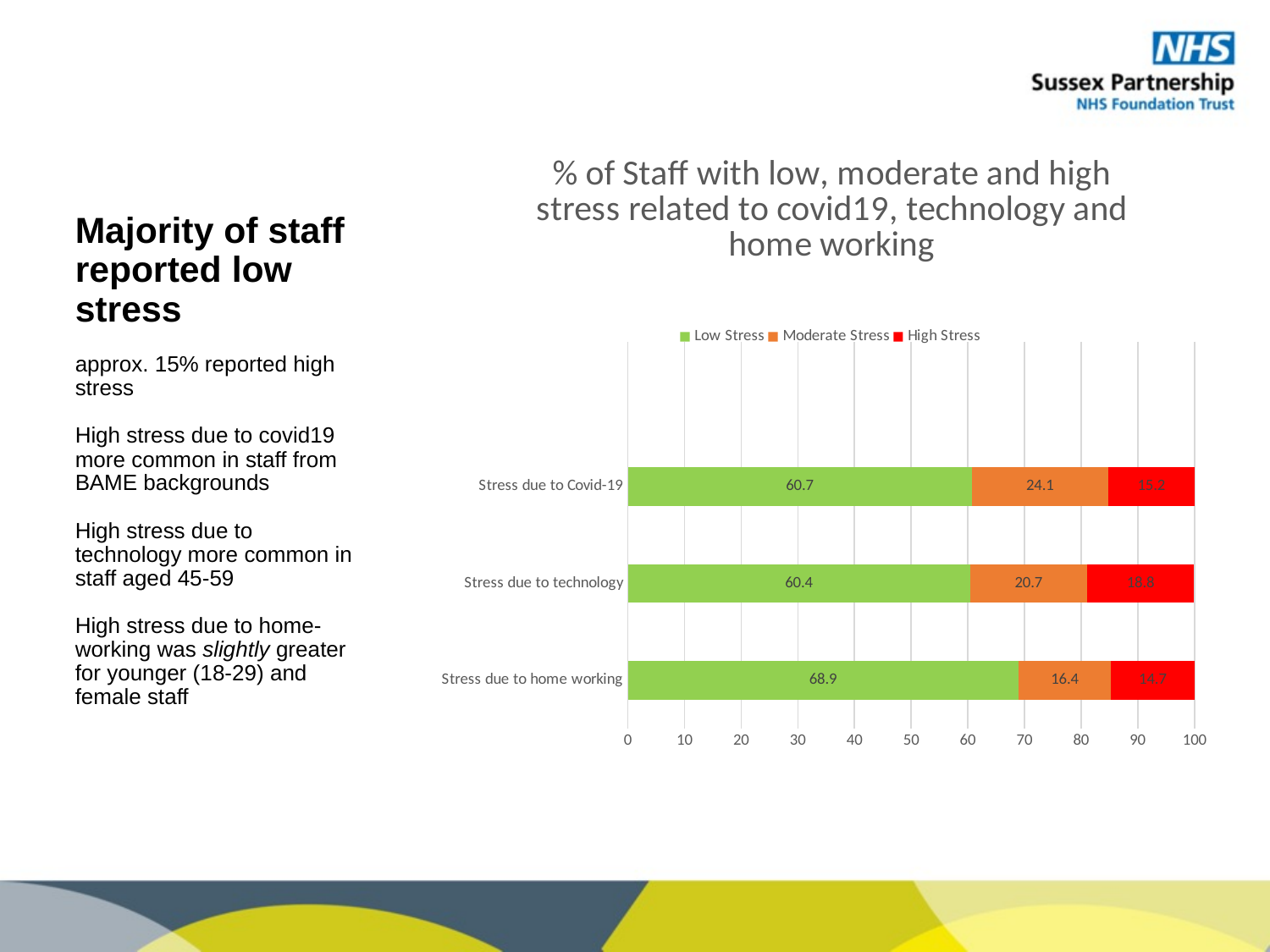
How many categories are shown on the chart? 3 How many series does the legend list? 3 What is the Low Stress value for Stress due to home working? 68.9 Which category has the highest Low Stress value? Stress due to home working Which is larger: the High Stress value for Stress due to technology or for Stress due to Covid-19? Stress due to technology Which colour represents High Stress in the chart? Red What is the total of the stacked bar for Stress due to technology? 99.9 What is the Moderate Stress value for Stress due to Covid-19? 24.1 What is the High Stress value for Stress due to technology? 18.8 What is the difference between the Moderate Stress values for Stress due to Covid-19 and Stress due to technology? 3.4 What kind of chart is shown on the slide? Stacked bar chart Which category has the lowest High Stress value? Stress due to home working